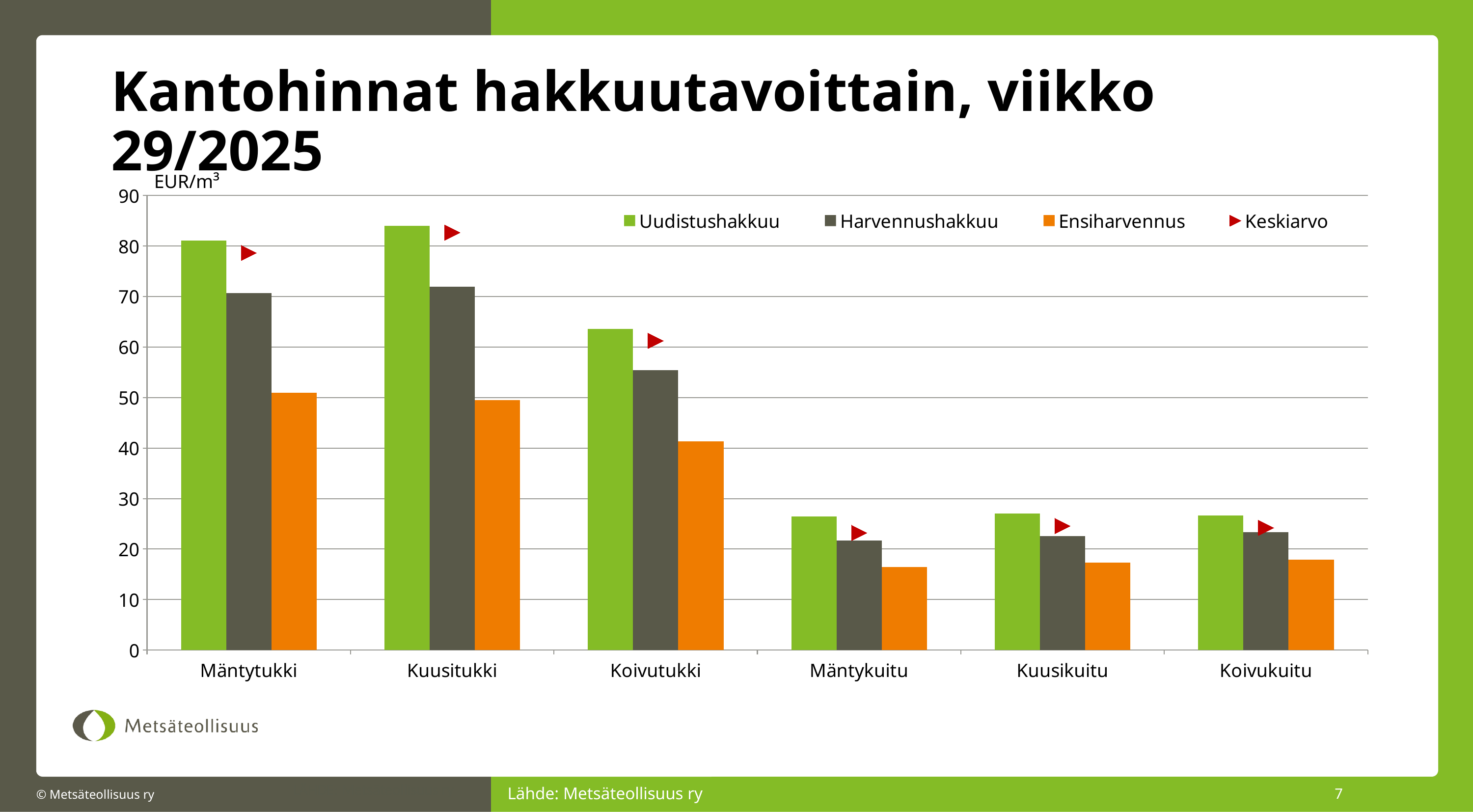
Is the Ensiharvennus value for Koivutukki greater or less than 40? greater Is the Harvennushakkuu value for Kuusitukki greater or less than 70? greater How many categories are shown on the x axis of the chart? 6 What kind of chart is shown on the slide? bar chart Which is larger: the Harvennushakkuu value for Koivutukki or the Ensiharvennus value for Mäntytukki? Harvennushakkuu value for Koivutukki Is the Uudistushakkuu value for Kuusitukki greater or less than 80? greater Which category has the highest Uudistushakkuu value? Kuusitukki How many series does the chart legend list? 4 Which legend entry is shown with a red triangle marker? Keskiarvo What unit is shown on the y axis of the chart? EUR/m³ Which is larger: the Harvennushakkuu value for Mäntytukki or the Uudistushakkuu value for Koivutukki? Harvennushakkuu value for Mäntytukki